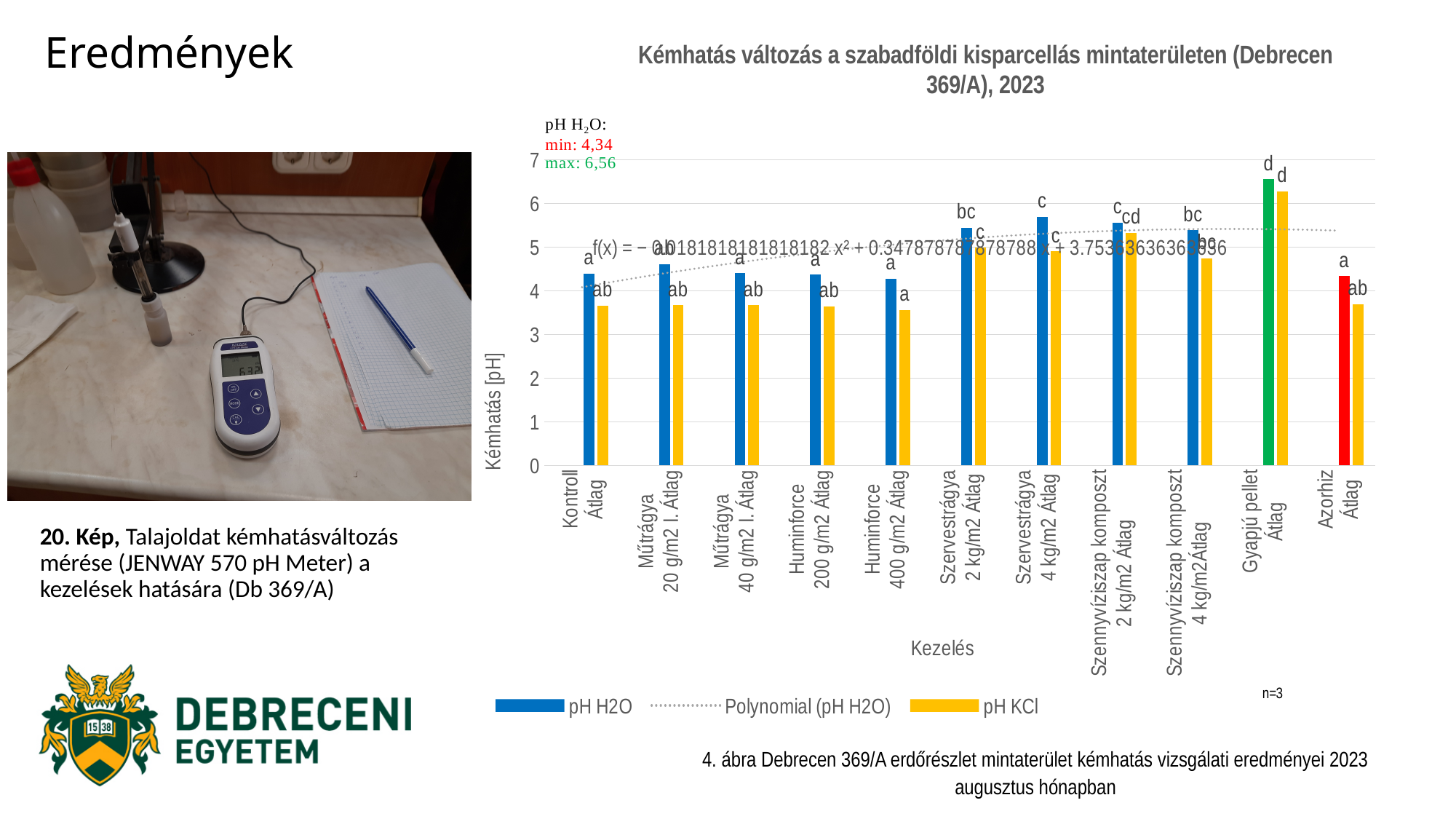
What kind of chart is shown on the slide? bar chart Is the pH H2O value for Gyapjú pellet Átlag greater or less than 6? greater According to the annotation on the chart, what is the maximum pH H2O value? 6,56 What is the title of the vertical axis of the chart? Kémhatás [pH] Is the pH H2O value for Szervestrágya 4 kg/m2 Átlag greater or less than 5? greater How many treatment categories are shown on the x axis of the chart? 11 According to the annotation on the chart, what is the minimum pH H2O value? 4,34 For Kontroll Átlag, which is larger: the pH H2O value or the pH KCl value? pH H2O Is the pH KCl value for Kontroll Átlag greater or less than 4? less Which treatment has the highest pH KCl value? Gyapjú pellet Átlag Which treatment has the highest pH H2O value? Gyapjú pellet Átlag How many entries does the chart legend list? 3